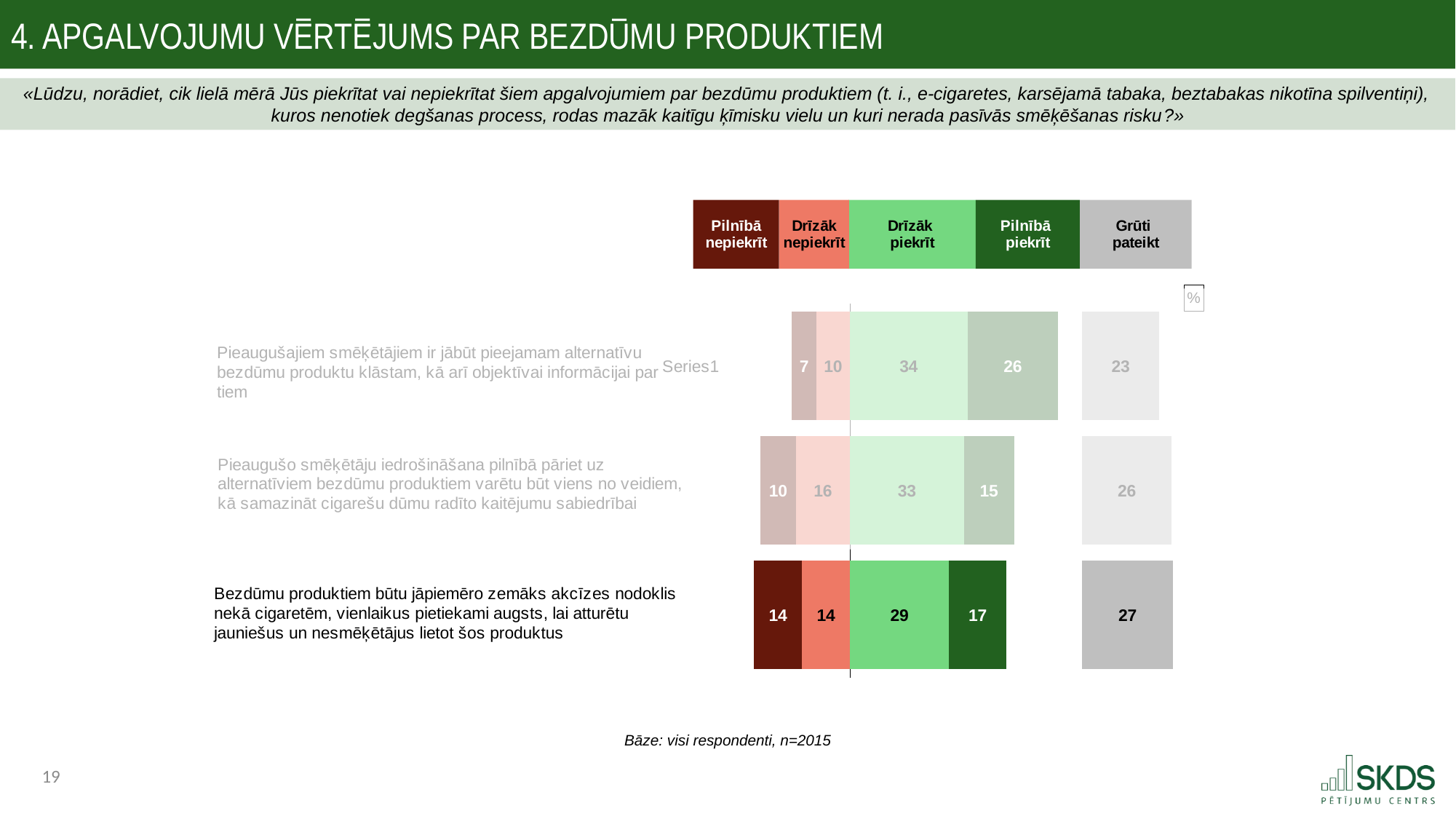
Which statement has the highest 'Pilnībā piekrīt' value? Pieaugušajiem smēķētājiem ir jābūt pieejamam alternatīvu bezdūmu produktu klāstam, kā arī objektīvai informācijai par tiem Which statement has the lowest 'Pilnībā nepiekrīt' value? Pieaugušajiem smēķētājiem ir jābūt pieejamam alternatīvu bezdūmu produktu klāstam, kā arī objektīvai informācijai par tiem How many response categories does the legend list? 5 Is the 'Drīzāk nepiekrīt' value larger for the statement about encouraging smokers to switch (second statement) or for the statement about excise tax (third statement)? Second statement (16) What is the difference between the 'Drīzāk piekrīt' values for the first statement (34) and the third statement about excise tax (29)? 5 What is the 'Grūti pateikt' value for the statement 'Bezdūmu produktiem būtu jāpiemēro zemāks akcīzes nodoklis nekā cigaretēm...'? 27 How many statements (bars) are plotted in the chart? 3 What colour represents the 'Pilnībā piekrīt' category in the legend? Dark green What is the 'Pilnībā piekrīt' value for the statement 'Pieaugušo smēķētāju iedrošināšana pilnībā pāriet uz alternatīviem bezdūmu produktiem...'? 15 What is the 'Drīzāk piekrīt' value for the statement 'Pieaugušajiem smēķētājiem ir jābūt pieejamam alternatīvu bezdūmu produktu klāstam...'? 34 What kind of chart is shown on the slide? Stacked bar chart What is the total of the 'Pilnībā nepiekrīt' and 'Drīzāk nepiekrīt' values for the statement about excise tax (third statement)? 28